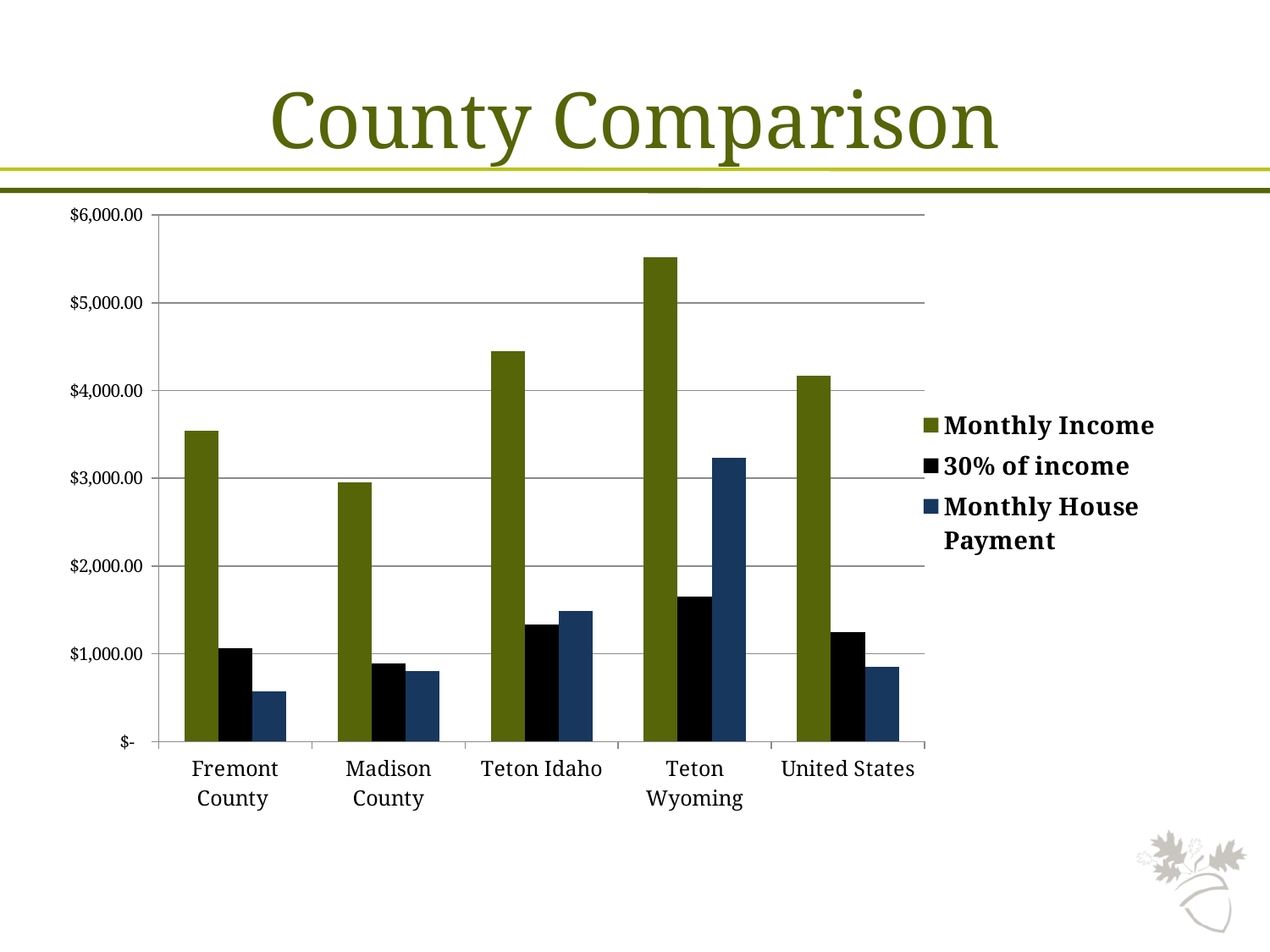
Is the Monthly Income for Teton Wyoming greater or less than $5,000.00? greater Which category has the lowest Monthly Income? Madison County How many categories are shown on the x axis? 5 What is the title of the slide? County Comparison Which is larger, the Monthly Income for Teton Idaho or for United States? Teton Idaho Which category has the lowest Monthly House Payment? Fremont County What type of chart is shown on the slide? bar chart How many series does the legend list? 3 Is the Monthly House Payment for Teton Wyoming greater or less than $3,000.00? greater Which category has the highest Monthly Income? Teton Wyoming Which category has the highest Monthly House Payment? Teton Wyoming